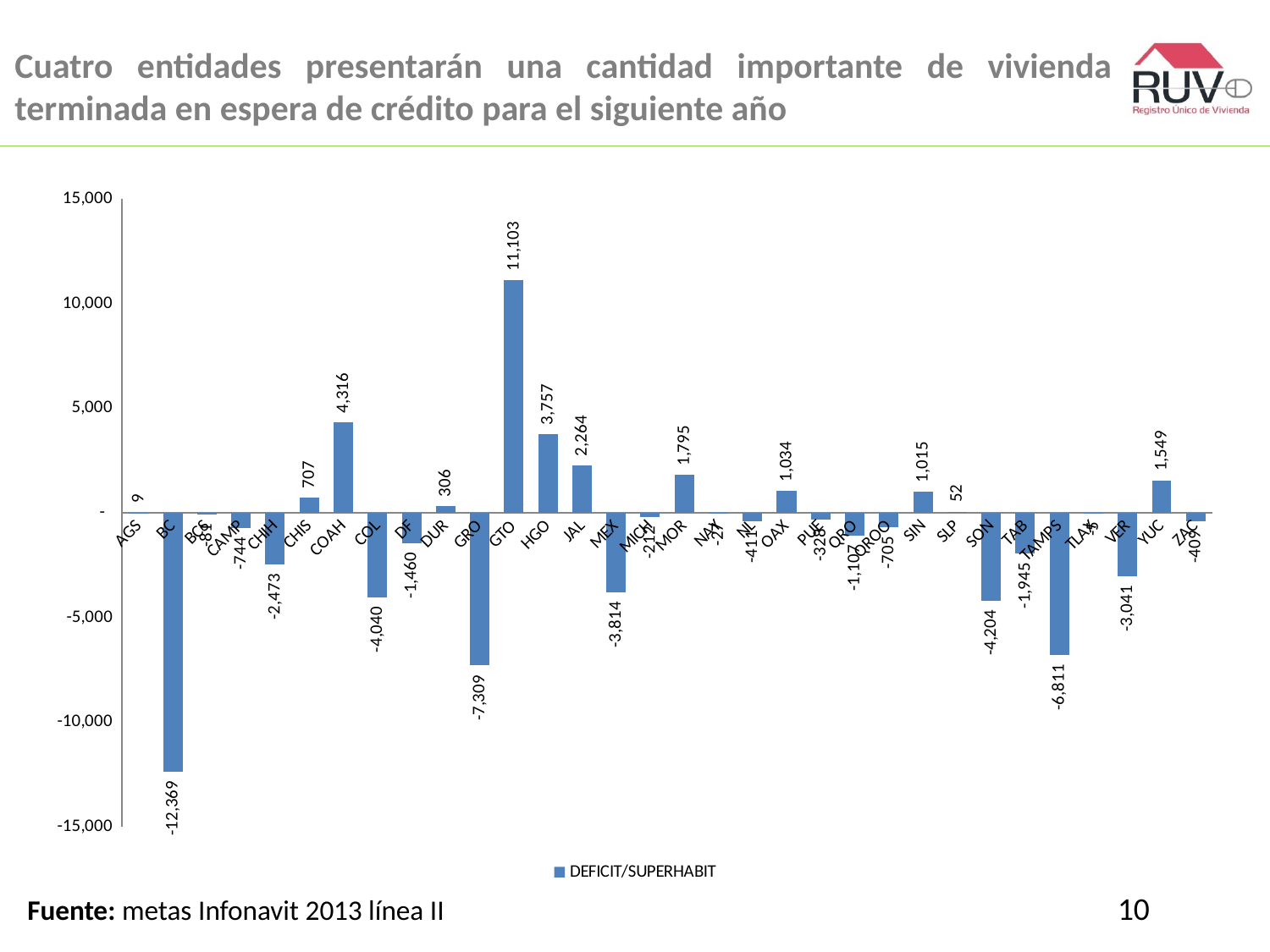
Which entity has the lowest value? BC What is the value for TAMPS? -6,811 Which entity has the highest value? GTO Which is larger, the value for HGO or the value for COAH? COAH How many entities are shown on the x axis? 32 What is the value for GTO? 11,103 What is the legend entry for the series? DEFICIT/SUPERHABIT What is the difference between the values for GTO and COAH? 6,787 How many series does the legend list? 1 What is the value for BC? -12,369 What kind of chart is shown on the slide? bar chart Is the value for GRO greater or less than -5,000? less